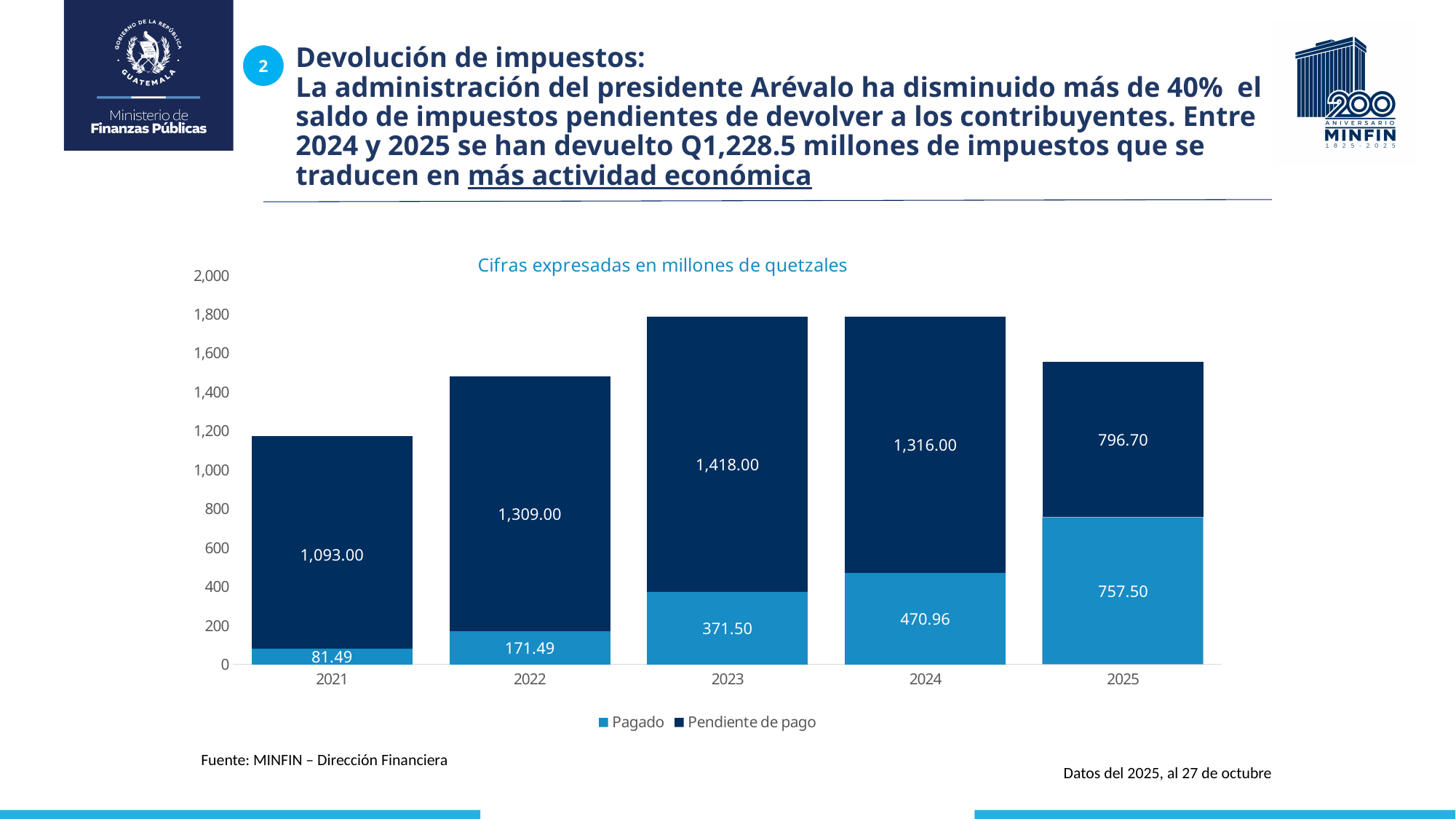
What is the difference between the Pendiente de pago values for 2024 and 2025? 519.30 How many years are shown on the x axis? 5 Which is larger, the Pagado value for 2025 or the Pendiente de pago value for 2025? Pendiente de pago Which year has the highest Pendiente de pago value? 2023 What type of chart is shown on the slide? stacked bar chart How many series does the legend list? 2 What unit does the chart subtitle say the figures are expressed in? millones de quetzales What is the Pendiente de pago value for 2025? 796.70 What is the Pagado value for 2023? 371.50 Does the Pagado value rise or fall from 2021 to 2025? rise Which year has the lowest Pagado value? 2021 What is the total of the stacked bar for 2025? 1,554.20